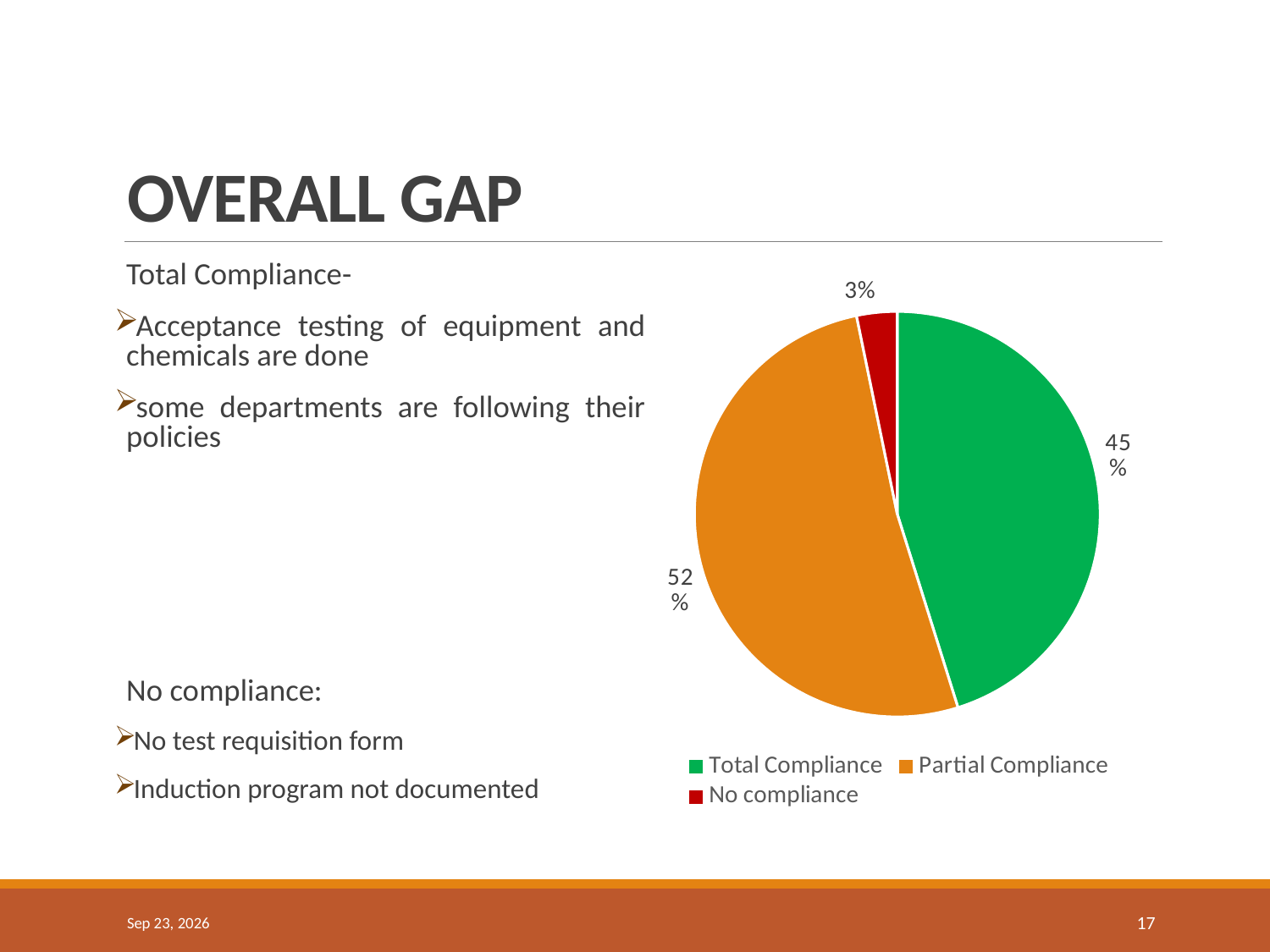
What is the difference between the Partial Compliance and Total Compliance shares? 7% How many entries does the legend list? 3 How many slices does the pie chart have? 3 What kind of chart is shown on the slide? pie chart Which is larger, Total Compliance or Partial Compliance? Partial Compliance What share of the pie is Total Compliance? 45% Which category has the smallest slice of the pie? No compliance What colour is the Total Compliance slice? green Which category has the largest slice of the pie? Partial Compliance What share of the pie is Partial Compliance? 52% What share of the pie is No compliance? 3% What is the difference between the Total Compliance and No compliance shares? 42%